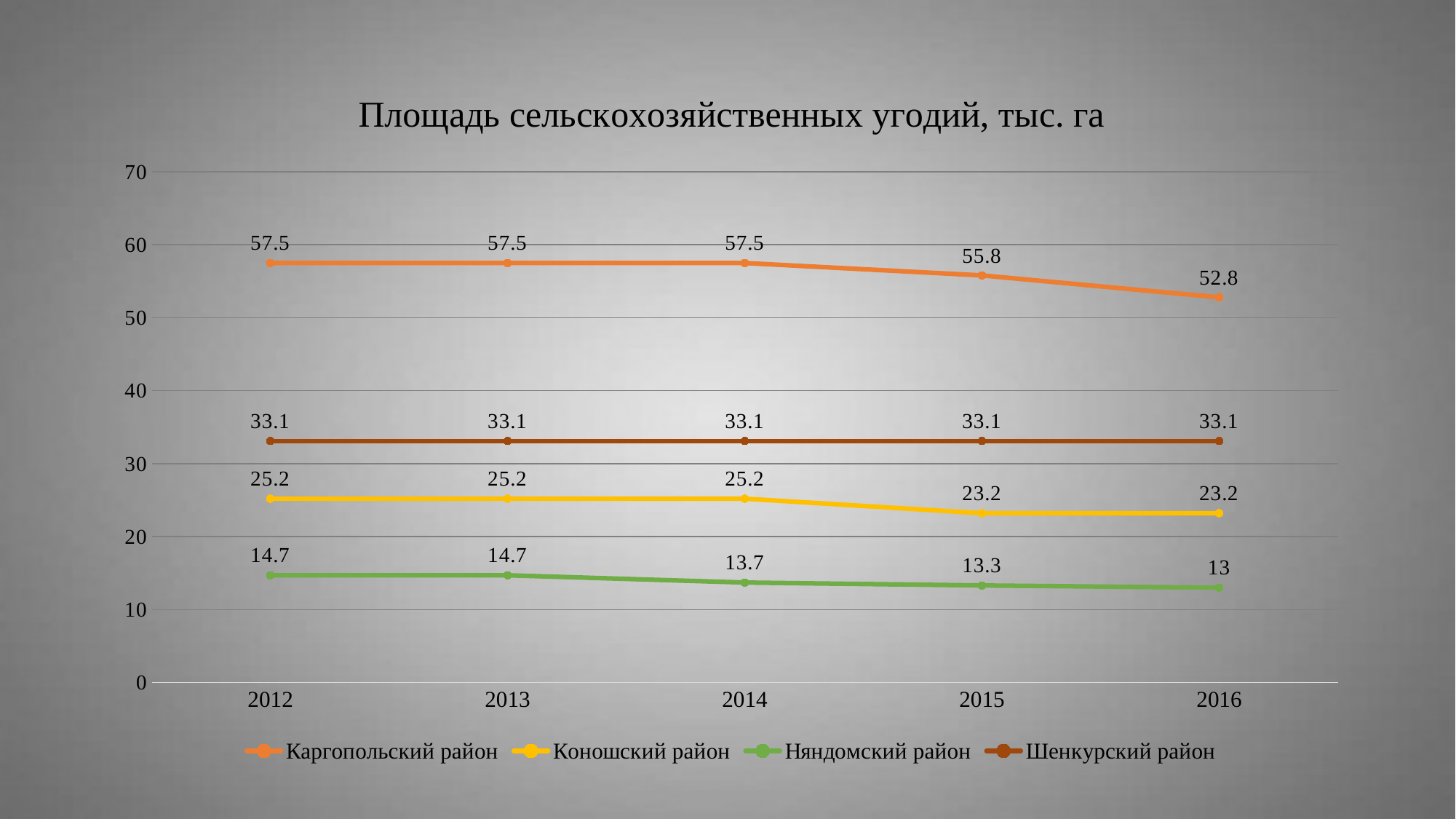
Does the value for Няндомский район rise or fall from 2012 to 2016? fall What is the value for Коношский район in 2015? 23.2 Which district has the highest value in 2012? Каргопольский район What is the value for Шенкурский район in 2013? 33.1 How many years are shown on the x axis? 5 What is the value for Няндомский район in 2014? 13.7 What is the difference between the Каргопольский район values in 2014 and 2016? 4.7 Which district has the lowest value in 2016? Няндомский район What kind of chart is shown on the slide? line chart How many series does the legend list? 4 Which is larger in 2015: the value for Шенкурский район or the value for Коношский район? Шенкурский район What is the value for Каргопольский район in 2016? 52.8